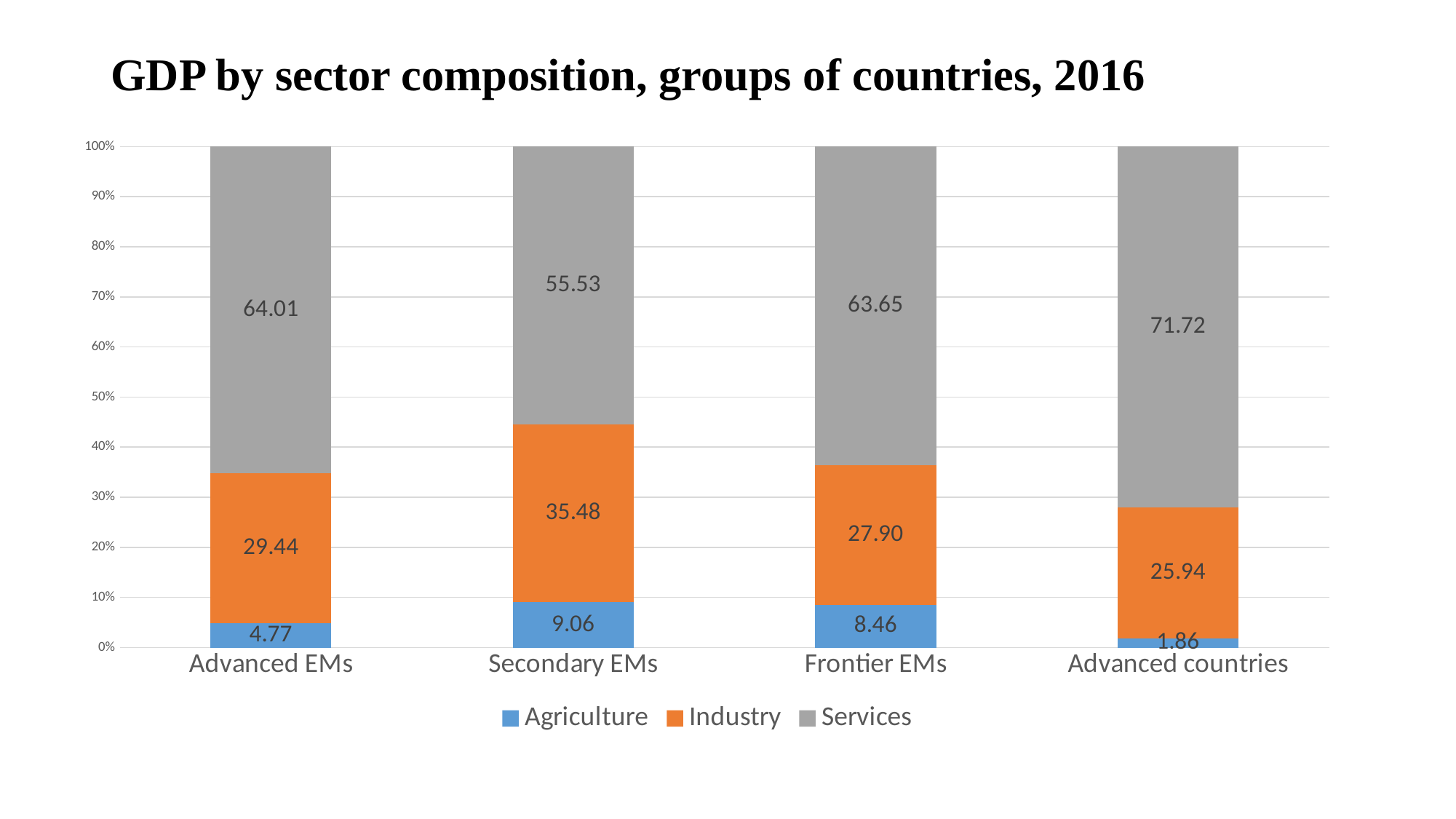
What is the title of the chart? GDP by sector composition, groups of countries, 2016 What is the Agriculture value for Secondary EMs? 9.06 Which colour represents Services in the chart? Grey How many series does the legend list? 3 What kind of chart is shown on the slide? Stacked bar chart Which group of countries has the highest Industry value? Secondary EMs What is the difference between the Services values for Advanced countries and Secondary EMs? 16.19 What is the Services value for Advanced countries? 71.72 Which is larger, the Industry value for Advanced EMs or for Advanced countries? Advanced EMs How many groups of countries are shown on the x axis? 4 What is the Industry value for Frontier EMs? 27.90 Which group of countries has the lowest Agriculture value? Advanced countries